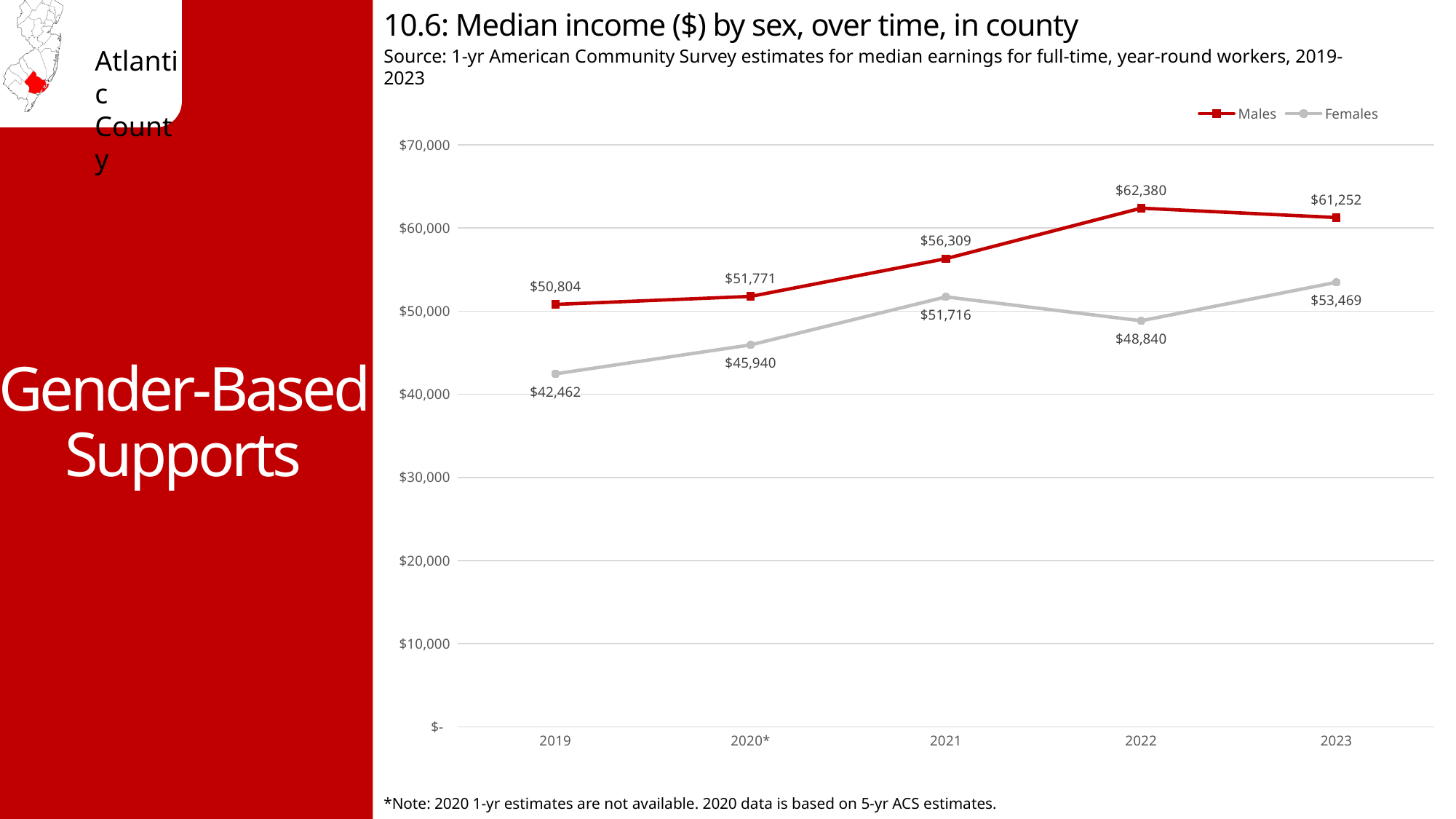
What is the median income for Females in 2023? $53,469 What is the median income for Males in 2022? $62,380 What is the median income for Females in 2019? $42,462 How many series does the legend list? 2 In which year is the Males median income highest? 2022 Which is larger in 2020*: the Males or the Females median income? Males What is the difference between the Males and Females median income in 2021? $4,593 What kind of chart is shown? line chart Is the Females median income in 2022 greater or less than $50,000? less In which year is the Females median income lowest? 2019 How many years are shown on the x axis? 5 Does the Males median income rise or fall from 2022 to 2023? fall